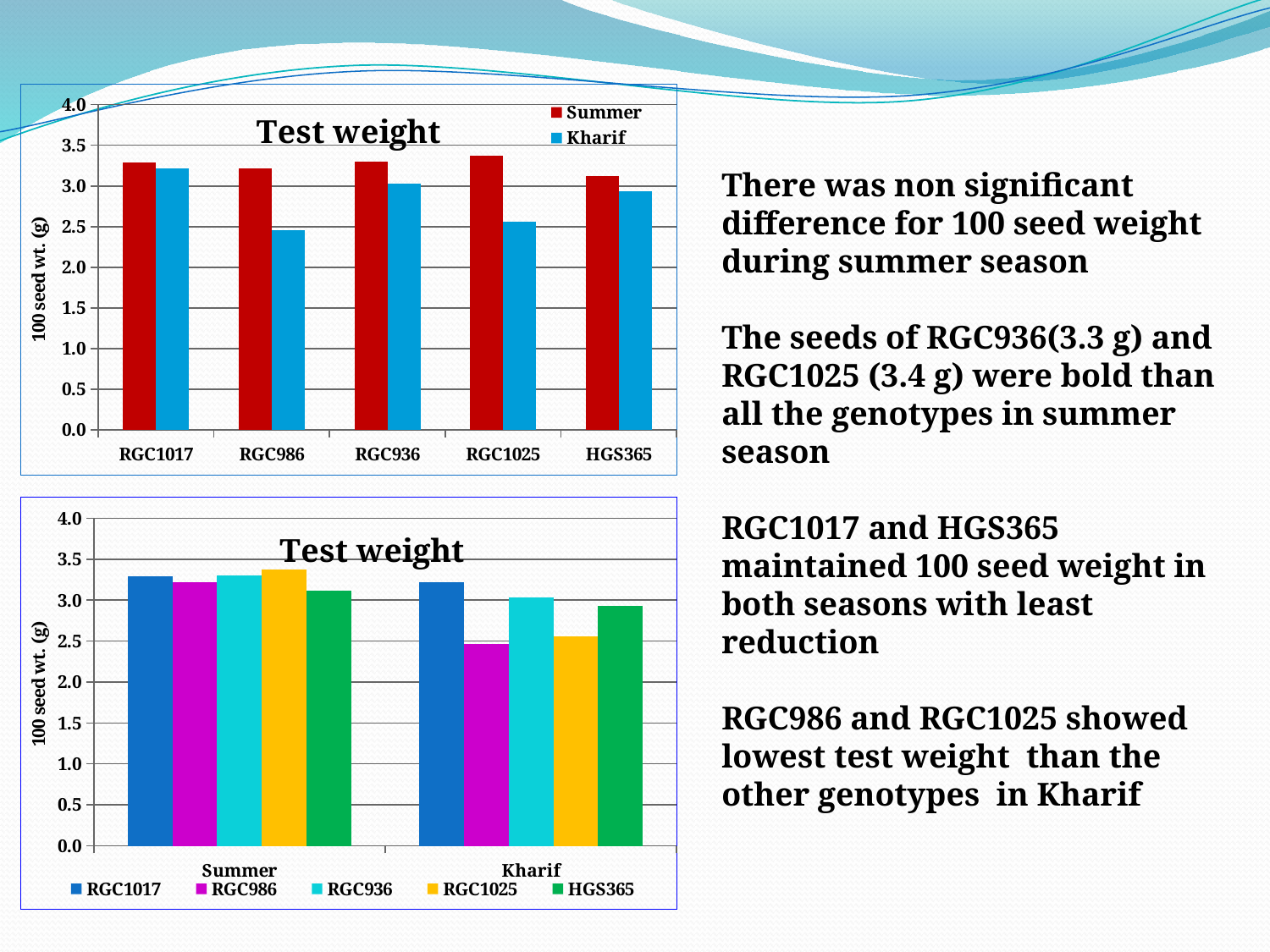
In the bottom chart, is the Kharif value for RGC1025 greater or less than 3.0? less How many categories are shown on the x axis of the bottom chart? 2 How many genotype categories are shown on the x axis of the top chart? 5 What is the y-axis label of the top chart? 100 seed wt. (g) What is the title of the bottom chart? Test weight In the top chart, is the Summer value for RGC1025 greater or less than 3.0? greater In the top chart, is the Kharif value for RGC986 greater or less than 3.0? less In the top chart, which is larger for RGC986, the Summer value or the Kharif value? Summer How many series does the legend of the top chart list? 2 What kind of chart is the top chart on the slide? bar chart How many series does the legend of the bottom chart list? 5 In the bottom chart, which is larger in Kharif, RGC1017 or RGC986? RGC1017